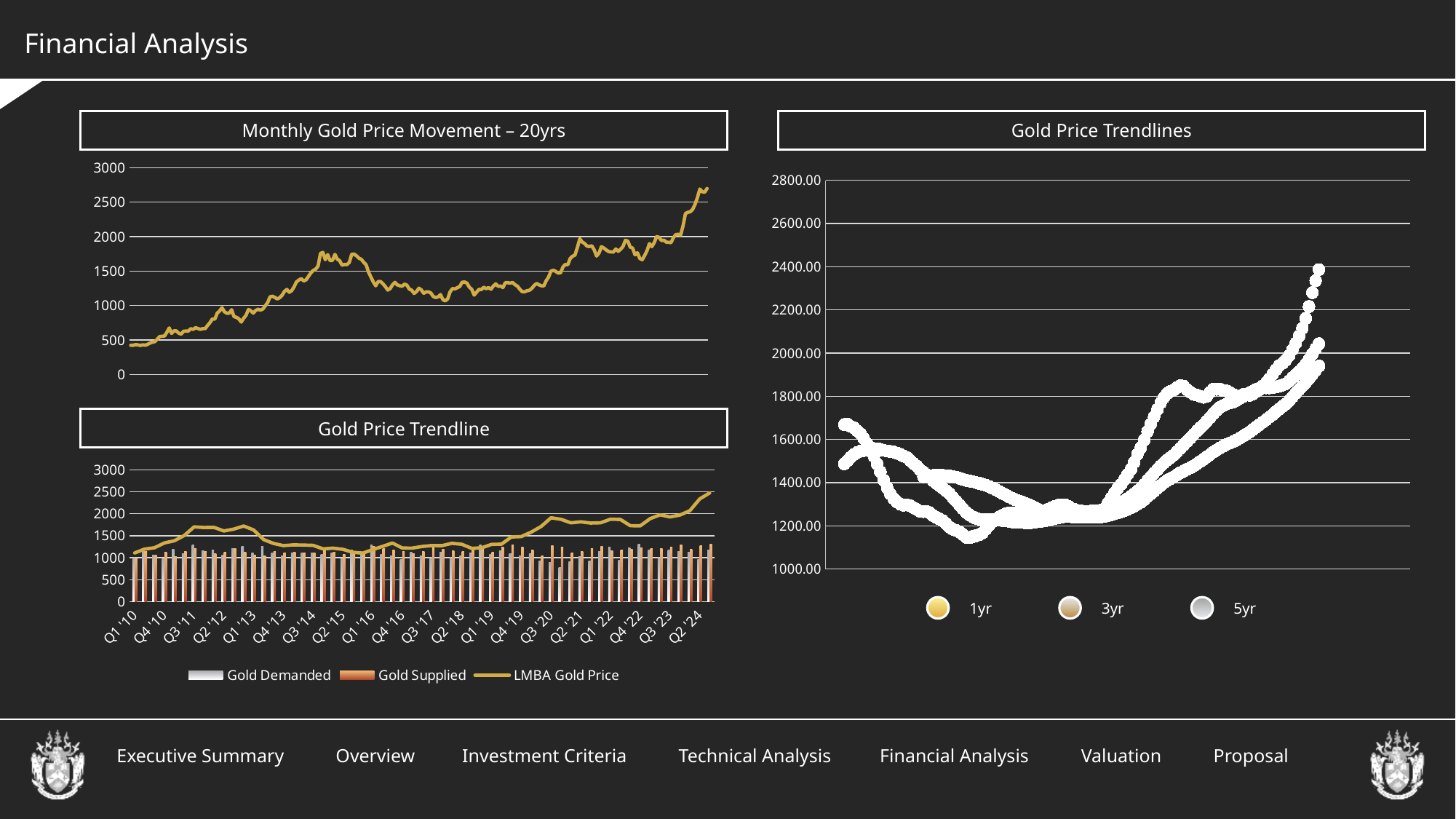
In the "Monthly Gold Price Movement – 20yrs" chart, is the value at the right end of the line greater or less than 2500? greater In the "Monthly Gold Price Movement – 20yrs" chart, is the value at the left end of the line greater or less than 1000? less Which series in the "Gold Price Trendline" chart is drawn as a line rather than bars? LMBA Gold Price How many series does the legend of the "Gold Price Trendline" chart list? 3 In the "Monthly Gold Price Movement – 20yrs" chart, does the line overall rise or fall from left to right? rise What kind of chart is the "Monthly Gold Price Movement – 20yrs" chart? line chart In the "Gold Price Trendlines" chart, is the lowest plotted point greater or less than 1200.00? less What are the legend entries of the "Gold Price Trendlines" chart? 1yr, 3yr, 5yr How many series does the legend of the "Gold Price Trendlines" chart list? 3